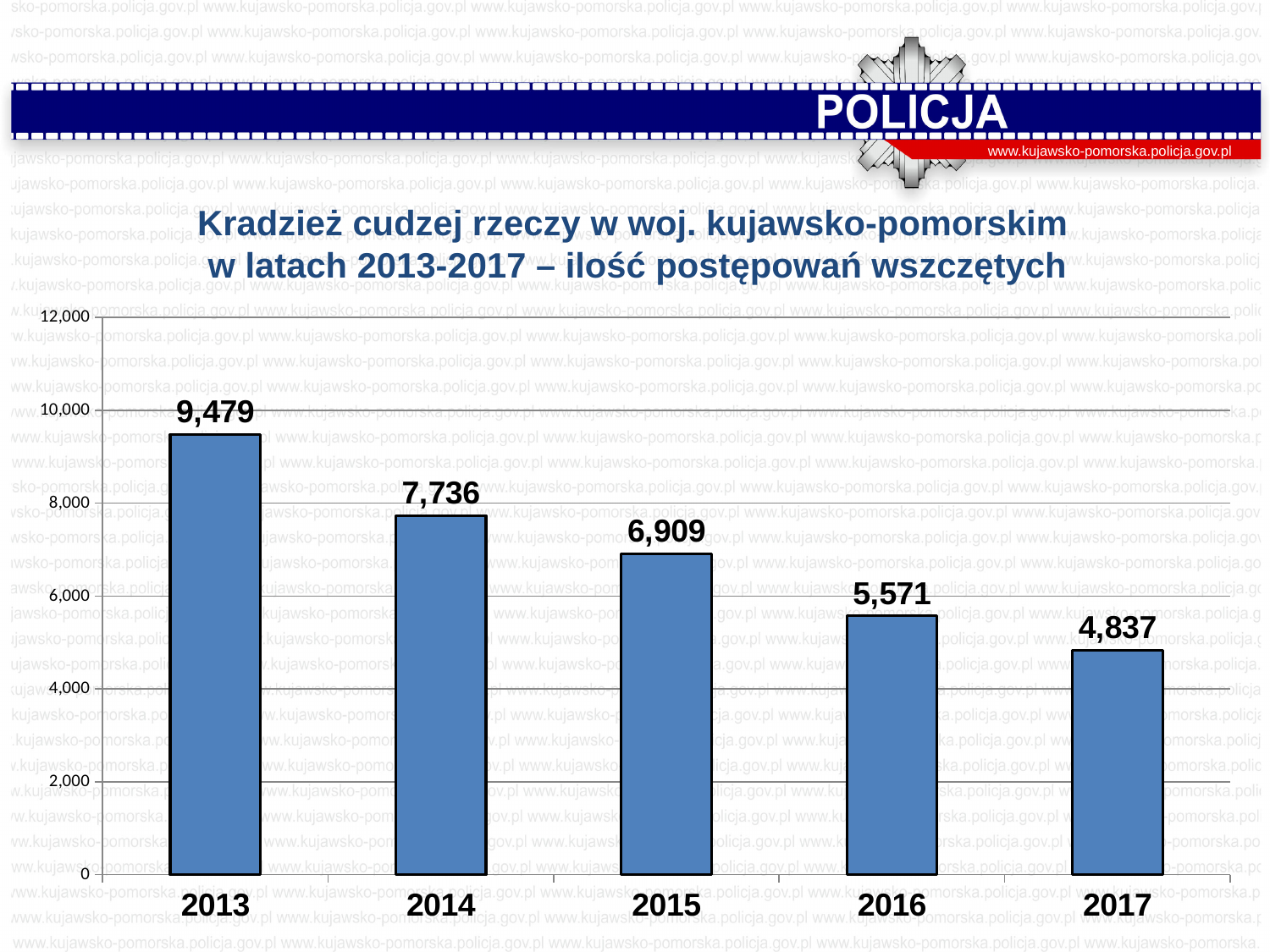
What is the difference between the values for 2014 and 2015? 827 What is the value for 2015? 6,909 What is the difference between the values for 2013 and 2017? 4,642 Do the values rise or fall from 2013 to 2017? fall Which is larger, the value for 2014 or the value for 2016? 2014 Is the value for 2016 greater or less than 6,000? less What is the value for 2013? 9,479 What is the value for 2017? 4,837 What kind of chart is shown on the slide? bar chart Which year has the lowest value? 2017 How many years are shown on the x axis? 5 Which year has the highest value? 2013